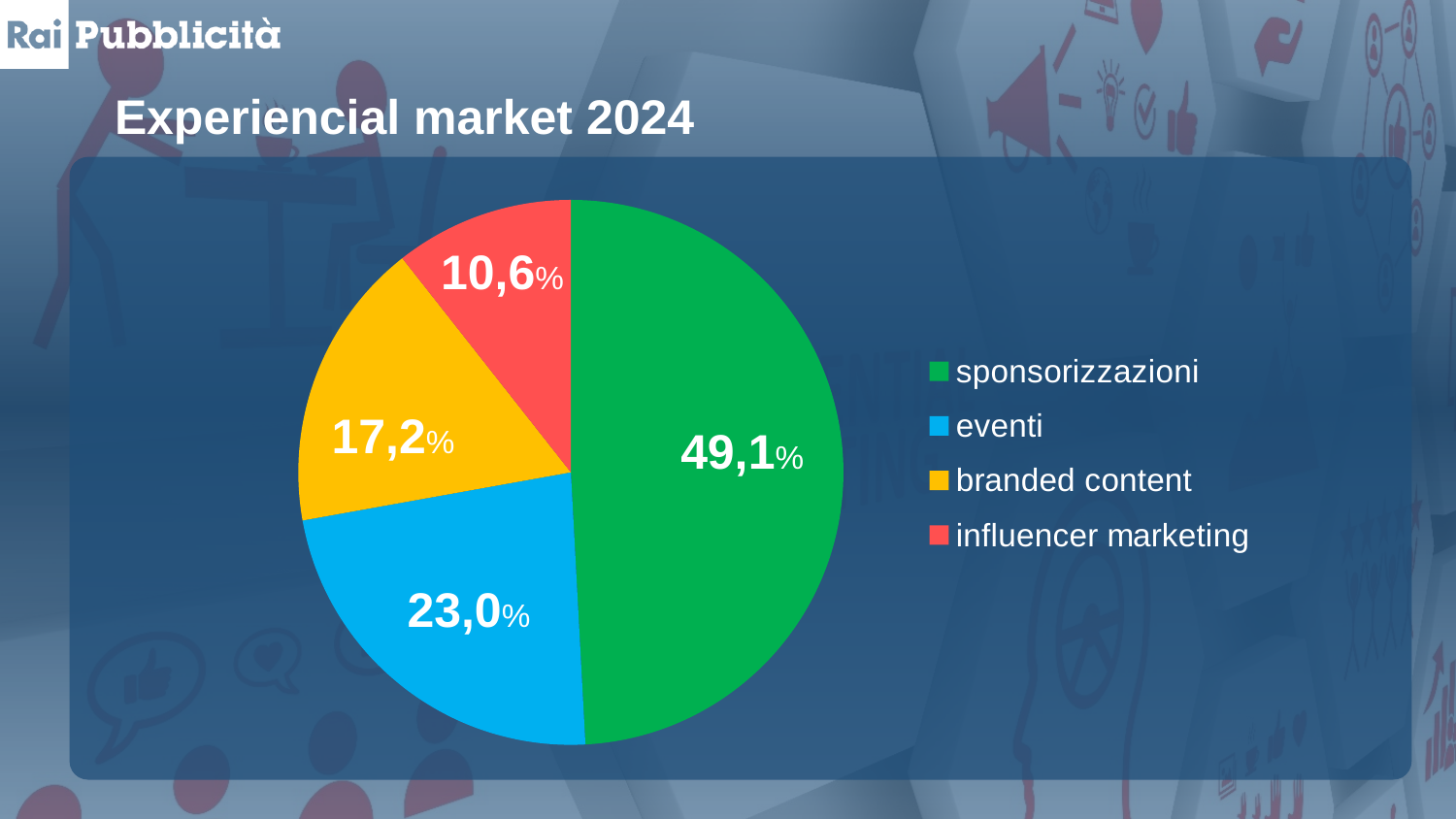
Which category has the largest slice of the pie? sponsorizzazioni What is the value shown for branded content? 17,2% What is the value shown for influencer marketing? 10,6% Which category has the smallest slice of the pie? influencer marketing How many slices does the pie chart have? 4 What kind of chart is shown on the slide? pie chart What share of the pie does sponsorizzazioni hold? 49,1% What colour is the slice for branded content? yellow Which is larger, the share for eventi or the share for branded content? eventi What is the value shown for eventi? 23,0% What is the difference between the shares of sponsorizzazioni and eventi? 26,1% What is the difference between the shares of branded content and influencer marketing? 6,6%